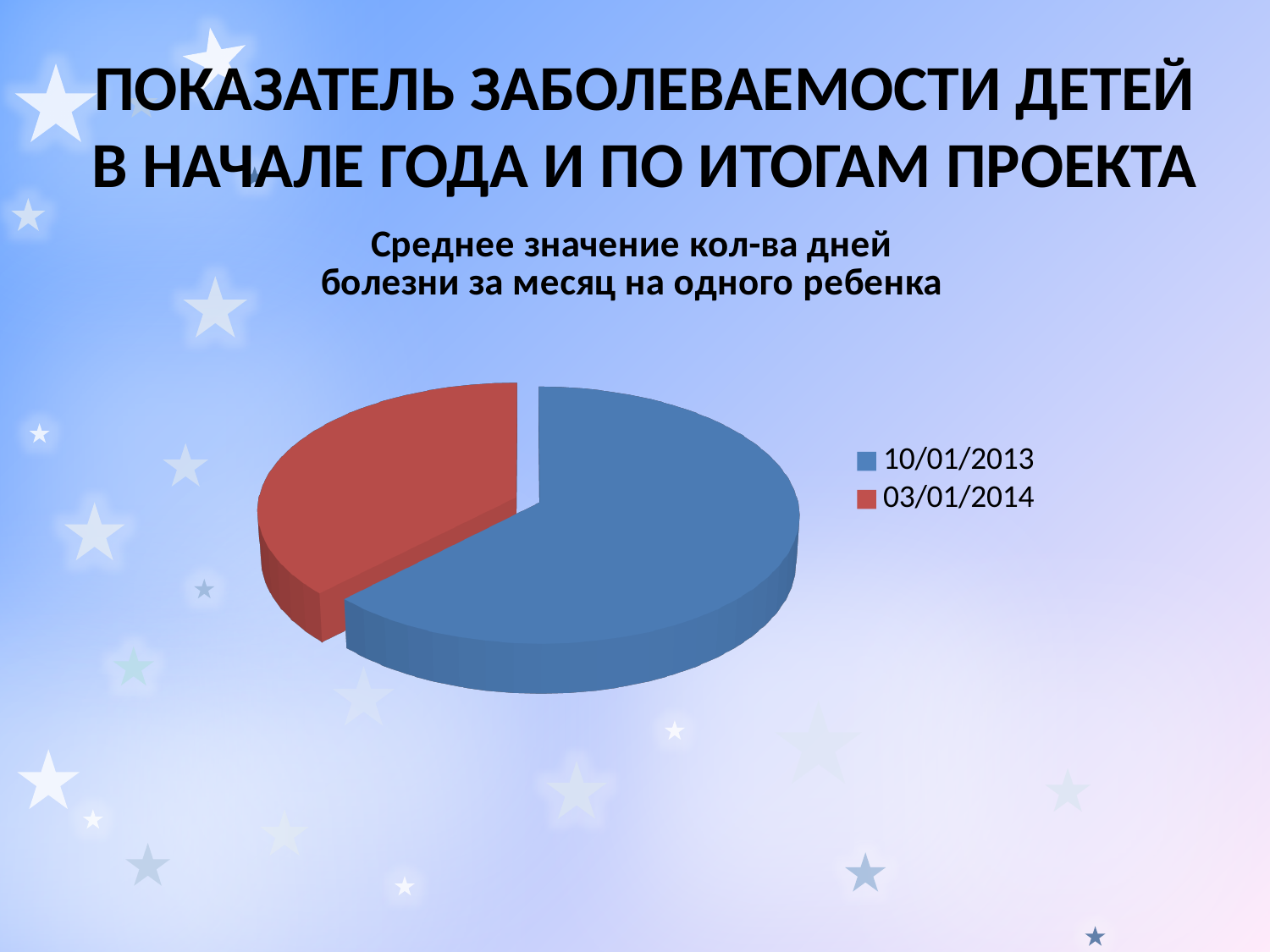
Is the share of the 10/01/2013 slice greater or less than half of the pie? greater Which category has the smallest slice in the pie chart? 03/01/2014 Which slice is larger: 10/01/2013 or 03/01/2014? 10/01/2013 What is the title of the pie chart? Среднее значение кол-ва дней болезни за месяц на одного ребенка Which category has the largest slice in the pie chart? 10/01/2013 What kind of chart is shown on the slide? pie chart What colour is the slice for 03/01/2014 in the pie chart? red How many entries does the legend of the pie chart list? 2 How many slices does the pie chart have? 2